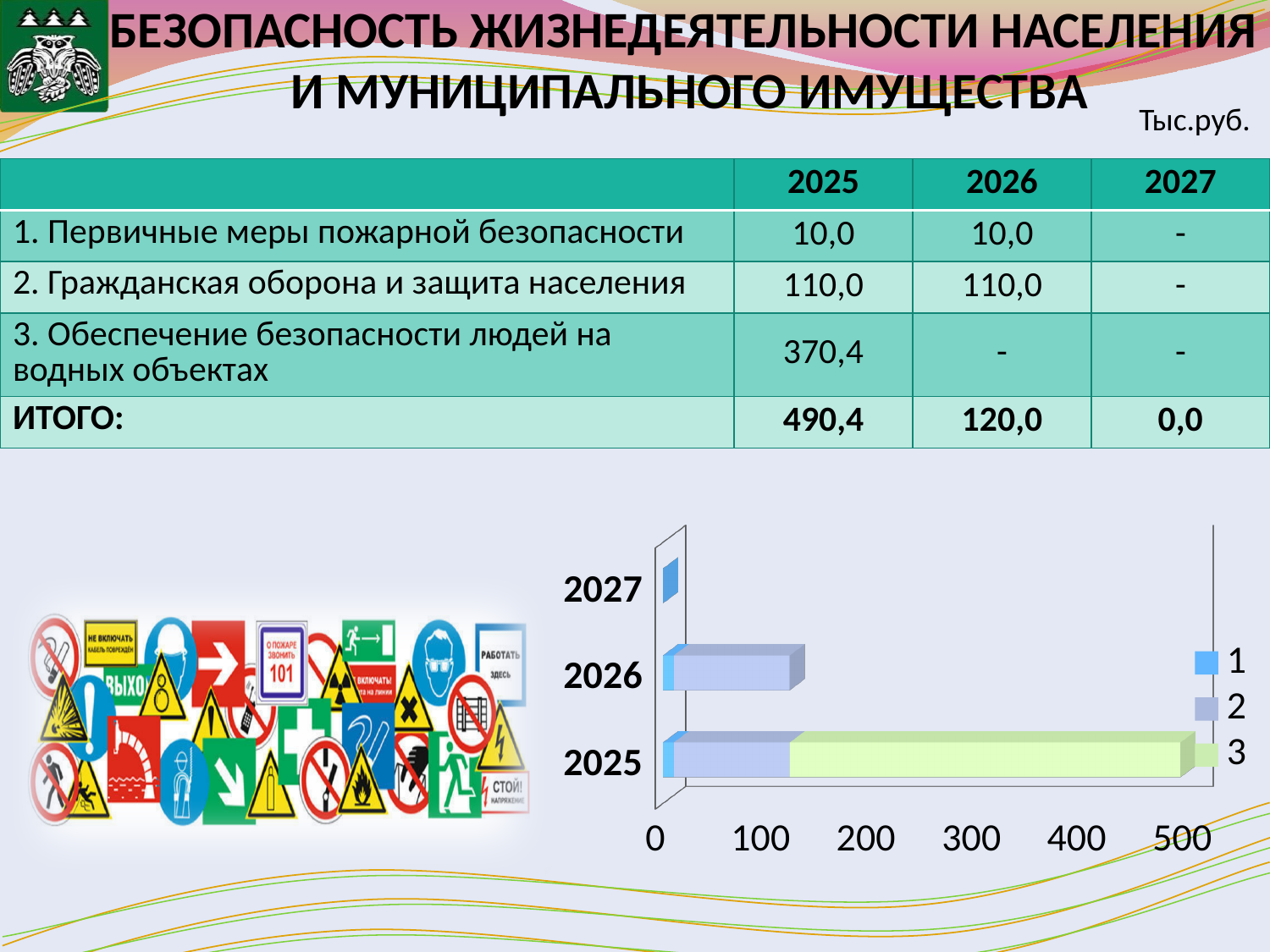
What is the highest tick value shown on the chart's horizontal axis? 500 What are the entries in the chart's legend? 1, 2, 3 Which year's bar contains a segment for series 3? 2025 Which year has the shortest bar in the chart? 2027 Is the total length of the 2026 bar greater or less than 200? less Which bar is longer in the chart, 2025 or 2026? 2025 Is the total length of the 2025 bar greater or less than 400? greater Do the bar lengths increase or decrease going from 2025 to 2027? decrease What kind of chart is shown on the slide? bar chart Which year has the longest bar in the chart? 2025 How many categories (years) are shown on the chart's vertical axis? 3 How many series does the chart's legend list? 3